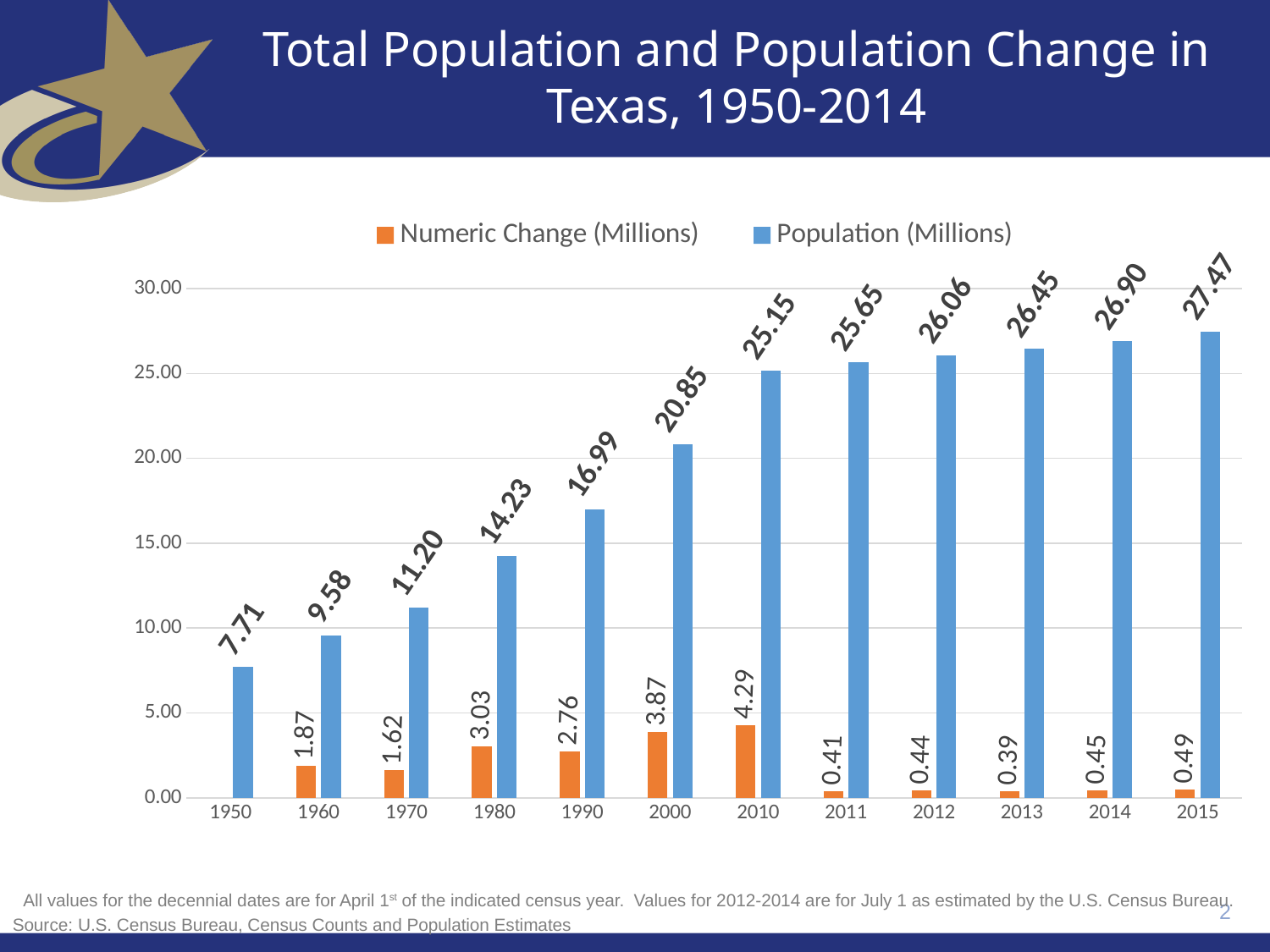
How many series does the legend list? 2 Is the Population (Millions) value for 1970 greater or less than 10.00? greater Which year has the larger Numeric Change (Millions) value, 1980 or 1990? 1980 Which year has the highest Numeric Change (Millions) value? 2010 What kind of chart is shown on the slide? bar chart What is the Population (Millions) value for 2000? 20.85 What is the difference between the Population (Millions) values for 2015 and 2010? 2.32 Which year has the lowest Numeric Change (Millions) value? 2013 What is the Population (Millions) value for 1950? 7.71 How many years are shown on the x axis of the chart? 12 Which year has the highest Population (Millions) value? 2015 What is the Numeric Change (Millions) value for 2010? 4.29